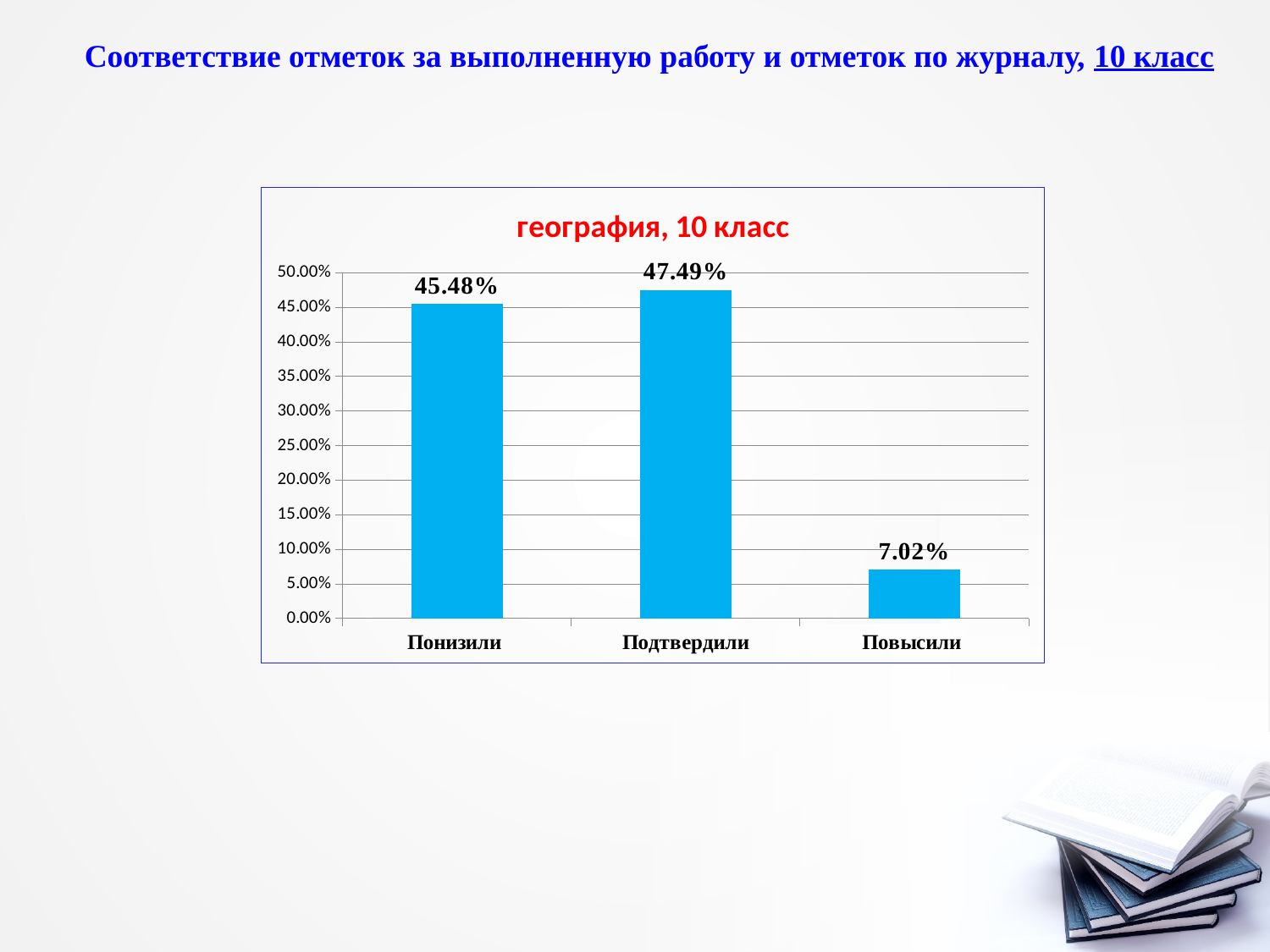
How many categories are shown on the x axis? 3 Which is larger, the value for Понизили or the value for Повысили? Понизили What is the difference between the values for Подтвердили and Понизили? 2.01% What is the title of the chart? география, 10 класс Is the value for Повысили greater or less than 10.00%? less Which category has the highest value? Подтвердили What is the value for Понизили? 45.48% Which category has the lowest value? Повысили What kind of chart is shown on the slide? bar chart What is the value for Подтвердили? 47.49% What is the value for Повысили? 7.02% What is the difference between the values for Понизили and Повысили? 38.46%